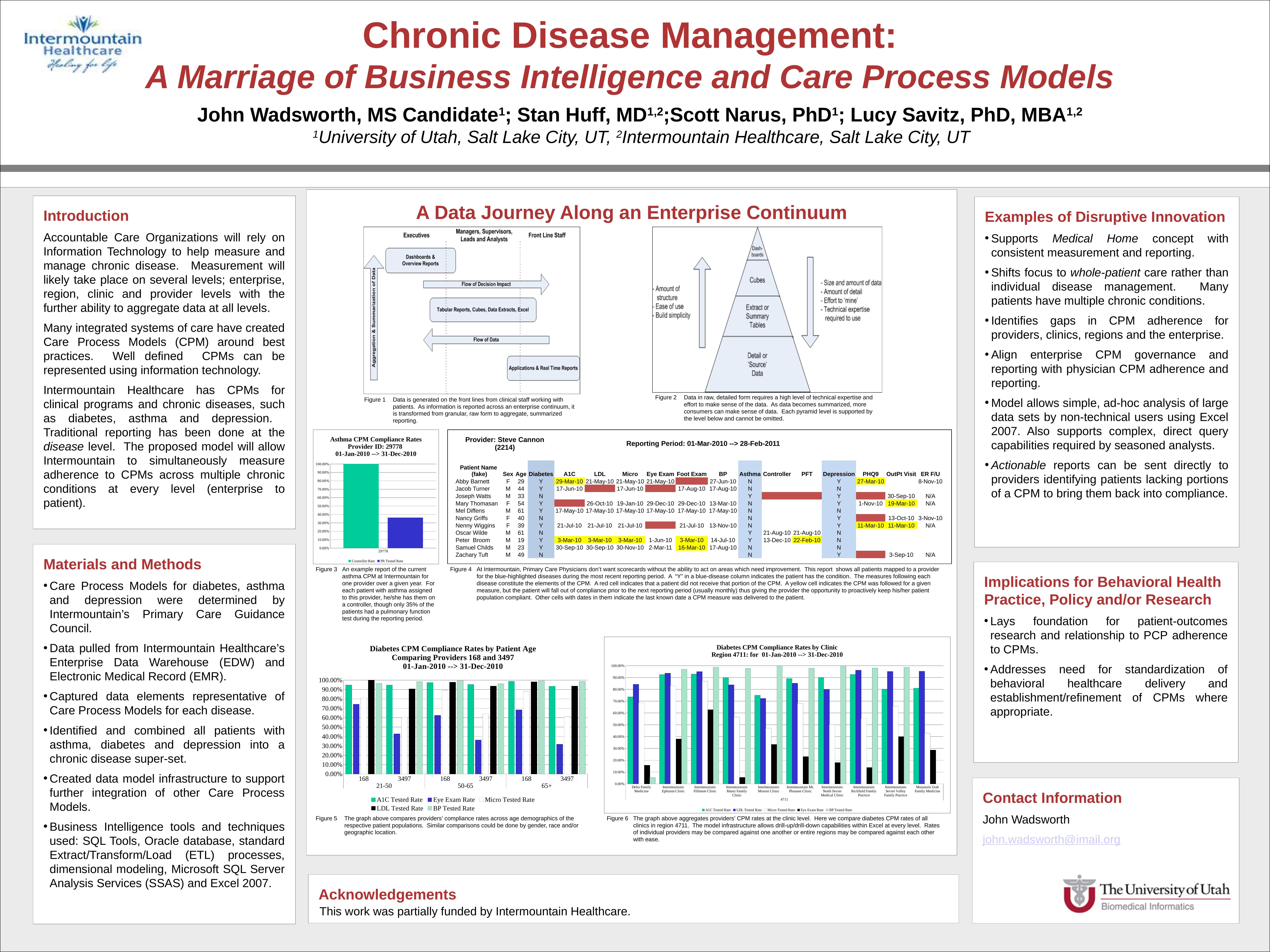
In the Diabetes CPM Compliance Rates by Patient Age chart (Figure 5), which provider has the larger Eye Exam Rate in the 21-50 group, 168 or 3497? 168 In the Asthma CPM Compliance Rates chart (Figure 3), is the Controller Rate greater or less than 90%? greater In the Asthma CPM Compliance Rates chart (Figure 3), which is larger, the Controller Rate or the Pft Tested Rate? Controller Rate How many clinics are shown on the x axis of the Diabetes CPM Compliance Rates by Clinic chart (Figure 6)? 10 In the Diabetes CPM Compliance Rates by Patient Age chart (Figure 5), is the Eye Exam Rate for provider 3497 in the 21-50 group greater or less than 50.00%? less What kind of chart is the Asthma CPM Compliance Rates chart (Figure 3)? bar chart What is the provider ID shown in the title of the Asthma CPM Compliance Rates chart (Figure 3)? 29778 How many series does the legend of the Diabetes CPM Compliance Rates by Patient Age chart (Figure 5) list? 5 In the Diabetes CPM Compliance Rates by Clinic chart (Figure 6), is the Eye Exam Rate for Delta Family Medicine greater or less than 20.00%? less How many series does the legend of the Asthma CPM Compliance Rates chart (Figure 3) list? 2 How many age groups are shown on the x axis of the Diabetes CPM Compliance Rates by Patient Age chart (Figure 5)? 3